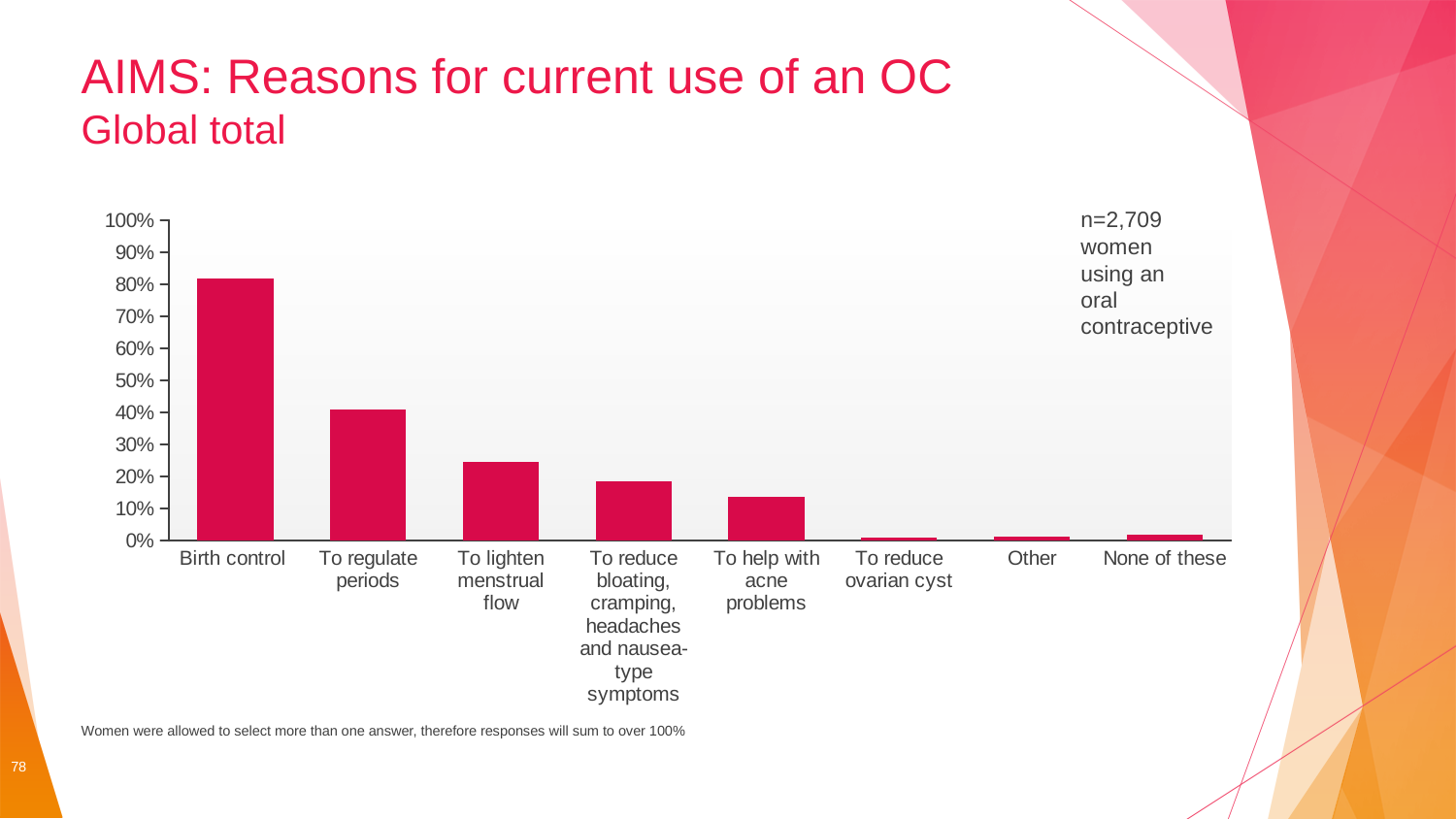
Is the value for To lighten menstrual flow greater or less than 20%? greater Do the bar values generally rise or fall moving from left to right across the first five categories? Fall Is the value for To reduce ovarian cyst greater or less than 10%? less What kind of chart is shown on the slide? Bar chart According to the note on the chart, how many women using an oral contraceptive were surveyed? n=2,709 Is the value for Birth control greater or less than 80%? greater Which reason for current use of an OC has the highest bar? Birth control Which is larger, the value for To help with acne problems or the value for None of these? To help with acne problems How many reasons (categories) are shown on the x axis of the chart? 8 Which is larger, the value for To regulate periods or the value for To lighten menstrual flow? To regulate periods